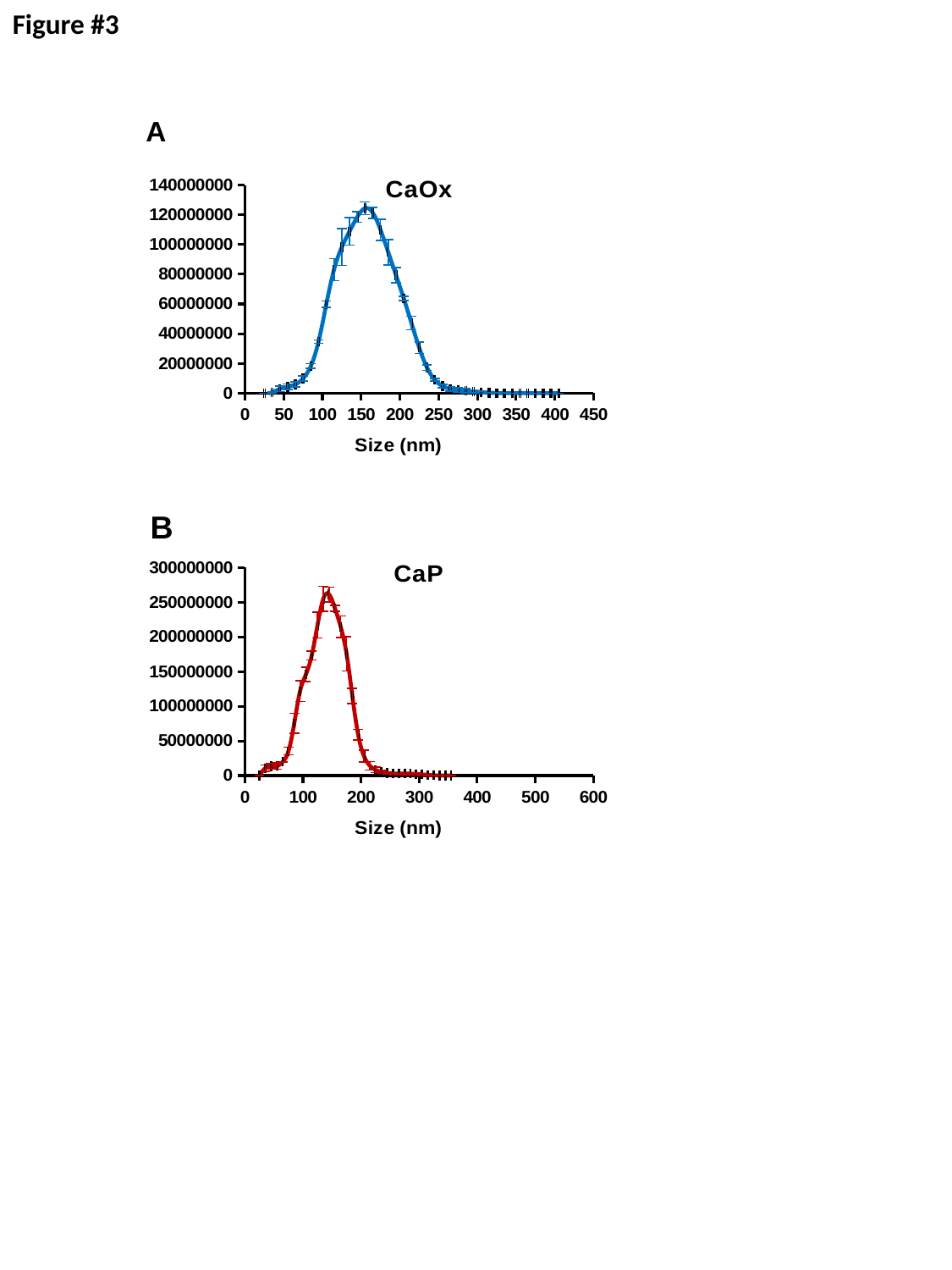
What is the title of the chart labelled B? CaP In chart B (CaP), is the value at 300 nm greater or less than 50000000? less In chart B (CaP), is the peak value of the curve greater or less than 200000000? greater In chart A (CaOx), is the value at 300 nm greater or less than 20000000? less Which chart shows the higher peak value, A (CaOx) or B (CaP)? B (CaP) What kind of chart is chart A (CaOx)? line chart In chart A (CaOx), do the values rise or fall as size increases from 150 nm to 250 nm? fall What is the x-axis label on chart A (CaOx)? Size (nm) In chart B (CaP), do the values rise or fall as size increases from 50 nm to 140 nm? rise